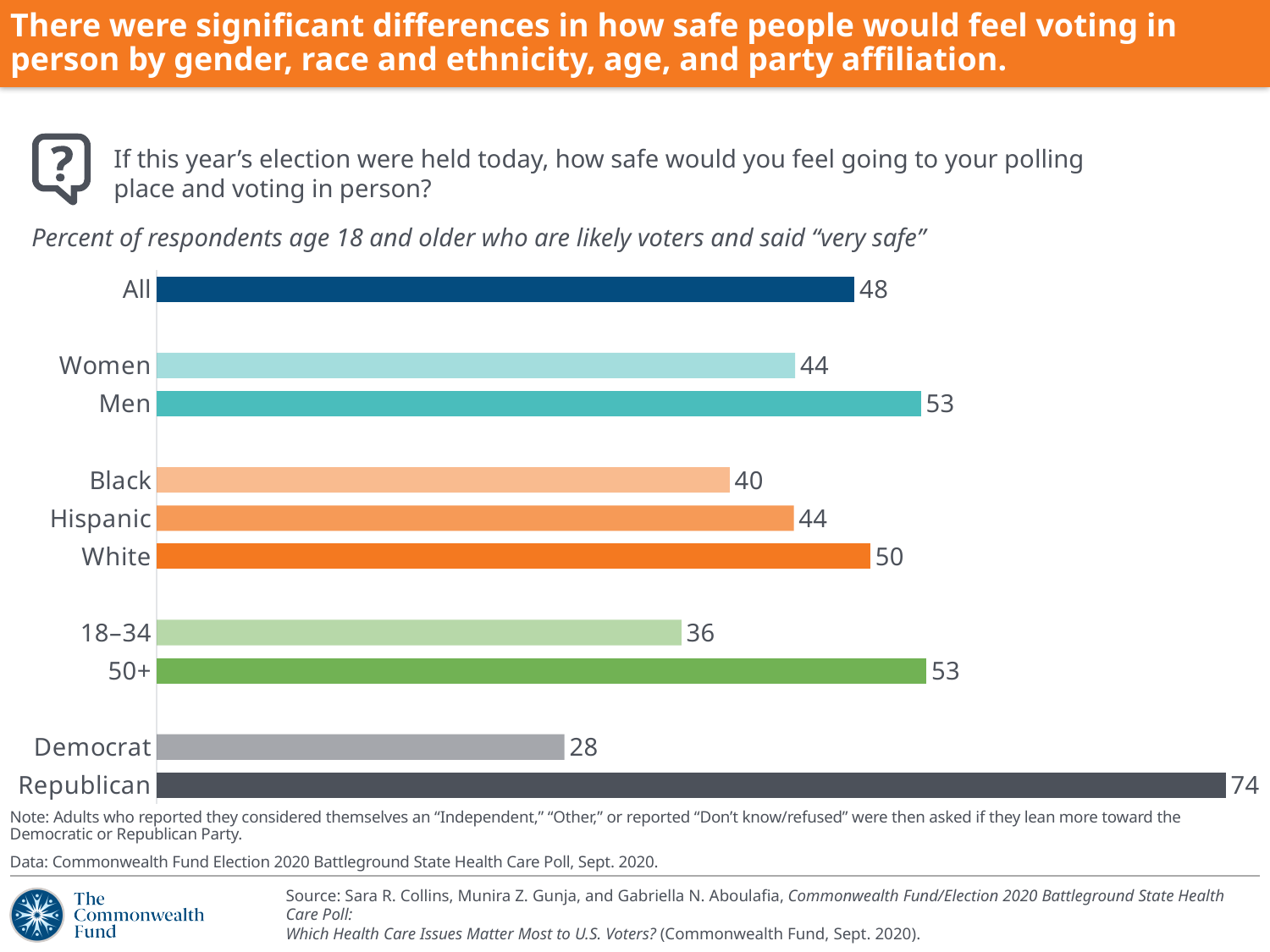
What is the value shown for Black respondents? 40 What percentage of all likely voters said they would feel "very safe" voting in person? 48 Which two categories share the same value of 53? Men and 50+ What is the difference between the values for Republican and Democrat respondents? 46 Which category has the highest value in the chart? Republican What is the value shown for respondents aged 18–34? 36 Which category has the lowest value in the chart? Democrat What is the difference between the values for Men and Women? 9 Which has a higher value, White respondents or Hispanic respondents? White What is the value shown for Republican respondents? 74 How many categories (bars) are shown in the chart? 10 What type of chart is shown on the slide? Bar chart